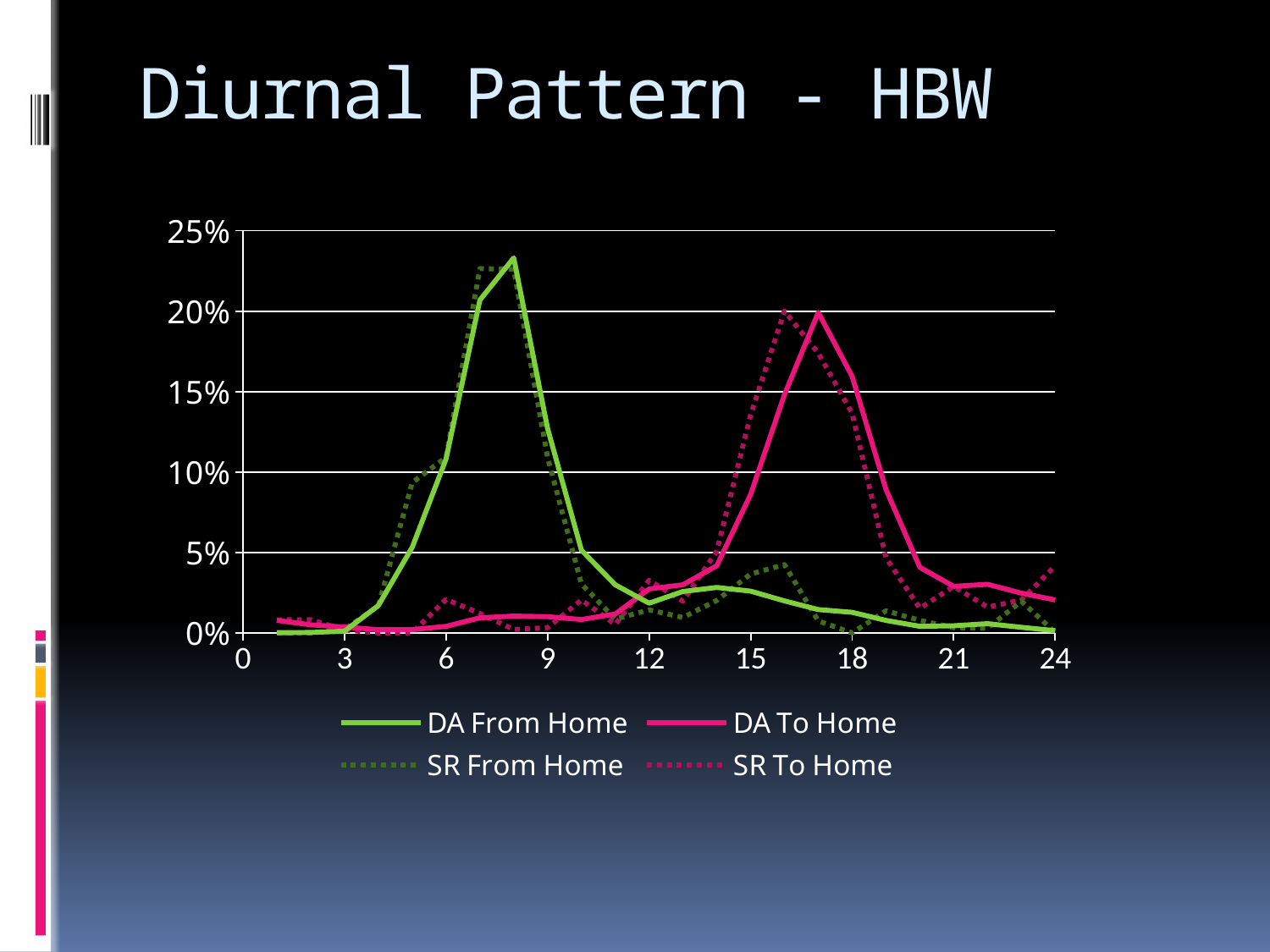
What is the title of the slide containing the chart? Diurnal Pattern - HBW Which series reaches the higher peak, DA From Home or DA To Home? DA From Home Is the value of DA To Home at hour 8 greater or less than 5%? less At hour 17, which series has the larger value, DA To Home or DA From Home? DA To Home Does the DA To Home series rise or fall between hour 12 and hour 17? rise What kind of chart is shown on the slide? line chart Is the peak value of the DA From Home series greater or less than 20%? greater How many series does the legend list? 4 Is the value of DA From Home at hour 8 greater or less than 15%? greater Does the DA From Home series rise or fall between hour 8 and hour 12? fall Which legend entries are drawn with dotted lines? SR From Home and SR To Home